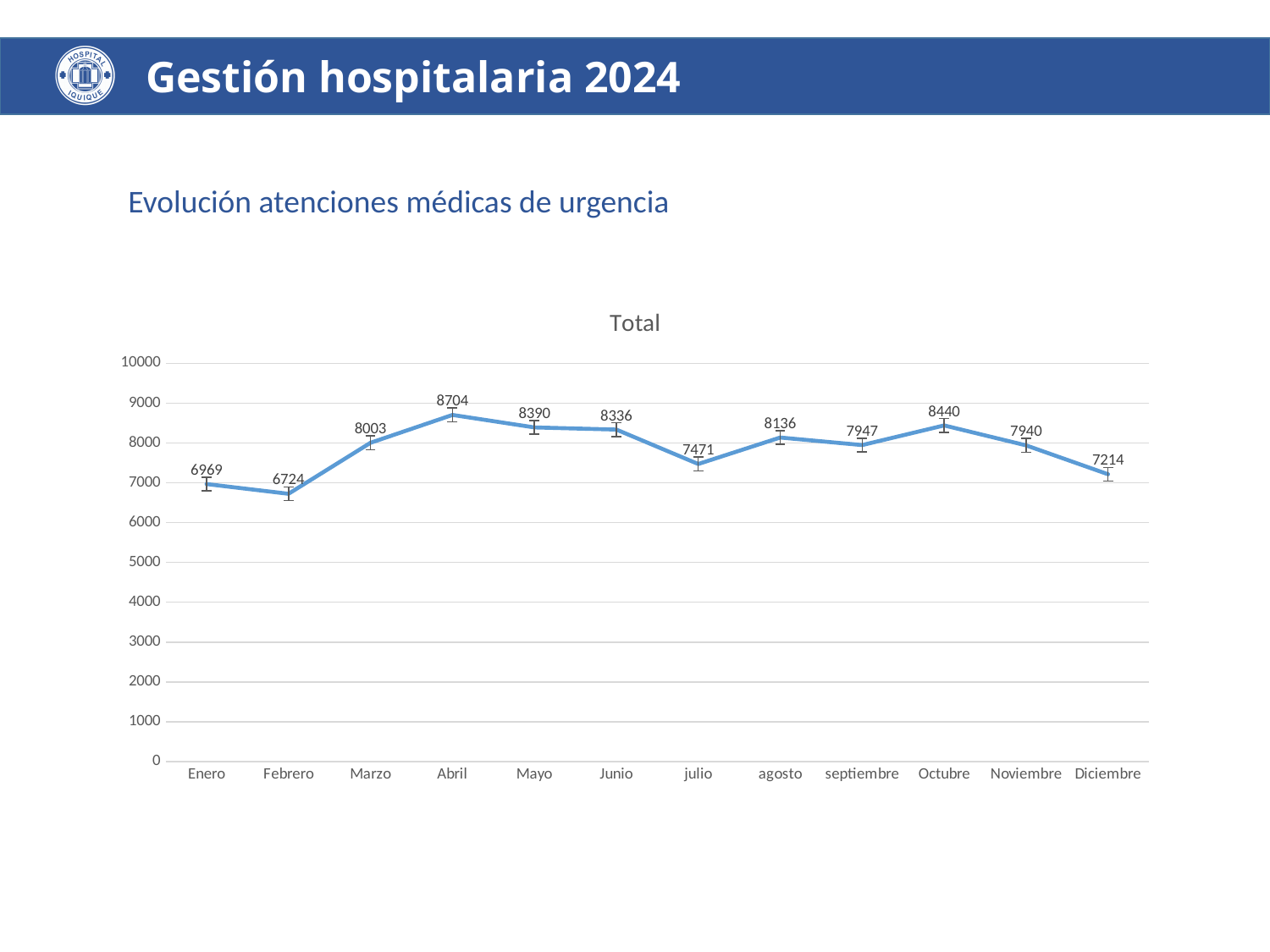
How many months are plotted on the x axis? 12 What is the value for septiembre? 7947 What is the title of the chart? Total What is the value for Abril? 8704 Is the value for julio greater or less than 7000? greater What kind of chart is shown? line chart Which is larger, the value for Mayo or the value for agosto? Mayo What is the difference between the values for Abril and Febrero? 1980 What is the value for Febrero? 6724 What is the difference between the values for Octubre and Diciembre? 1226 Which month has the highest value? Abril Which month has the lowest value? Febrero